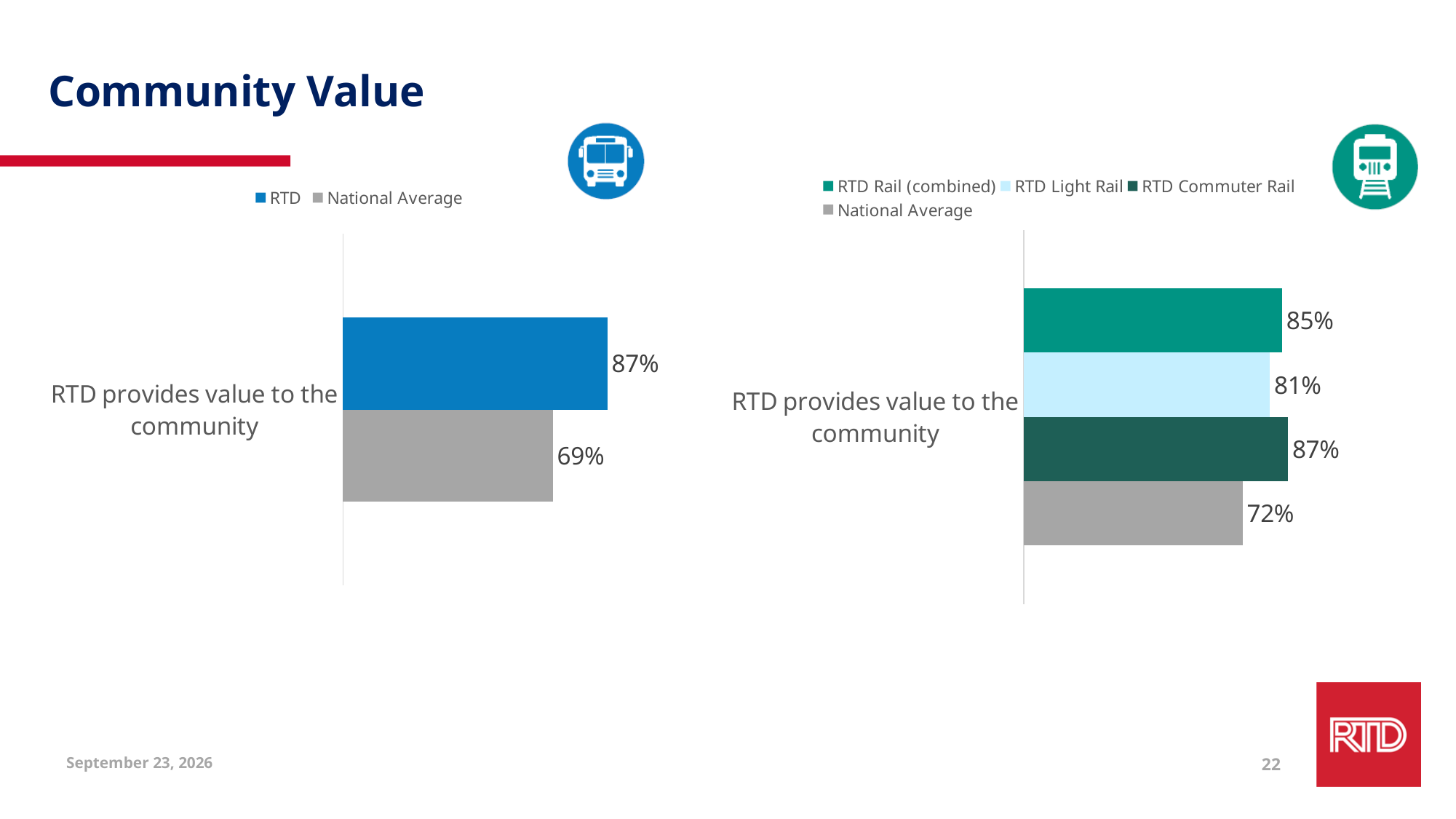
In the right (rail) chart, what is the value for RTD Commuter Rail? 87% In the left (bus) chart, what is the value for RTD? 87% In the left (bus) chart, what is the difference between the RTD value and the National Average value? 18% In the left (bus) chart, what is the value for National Average? 69% In the left (bus) chart, which is larger, RTD or National Average? RTD In the right (rail) chart, what is the value for RTD Rail (combined)? 85% What kind of chart is the left (bus) chart? Bar chart In the right (rail) chart, what is the difference between RTD Commuter Rail and National Average? 15% In the right (rail) chart, what is the value for RTD Light Rail? 81% In the right (rail) chart, which series has the lowest value? National Average In the left (bus) chart, how many series does the legend list? 2 In the right (rail) chart, how many series does the legend list? 4